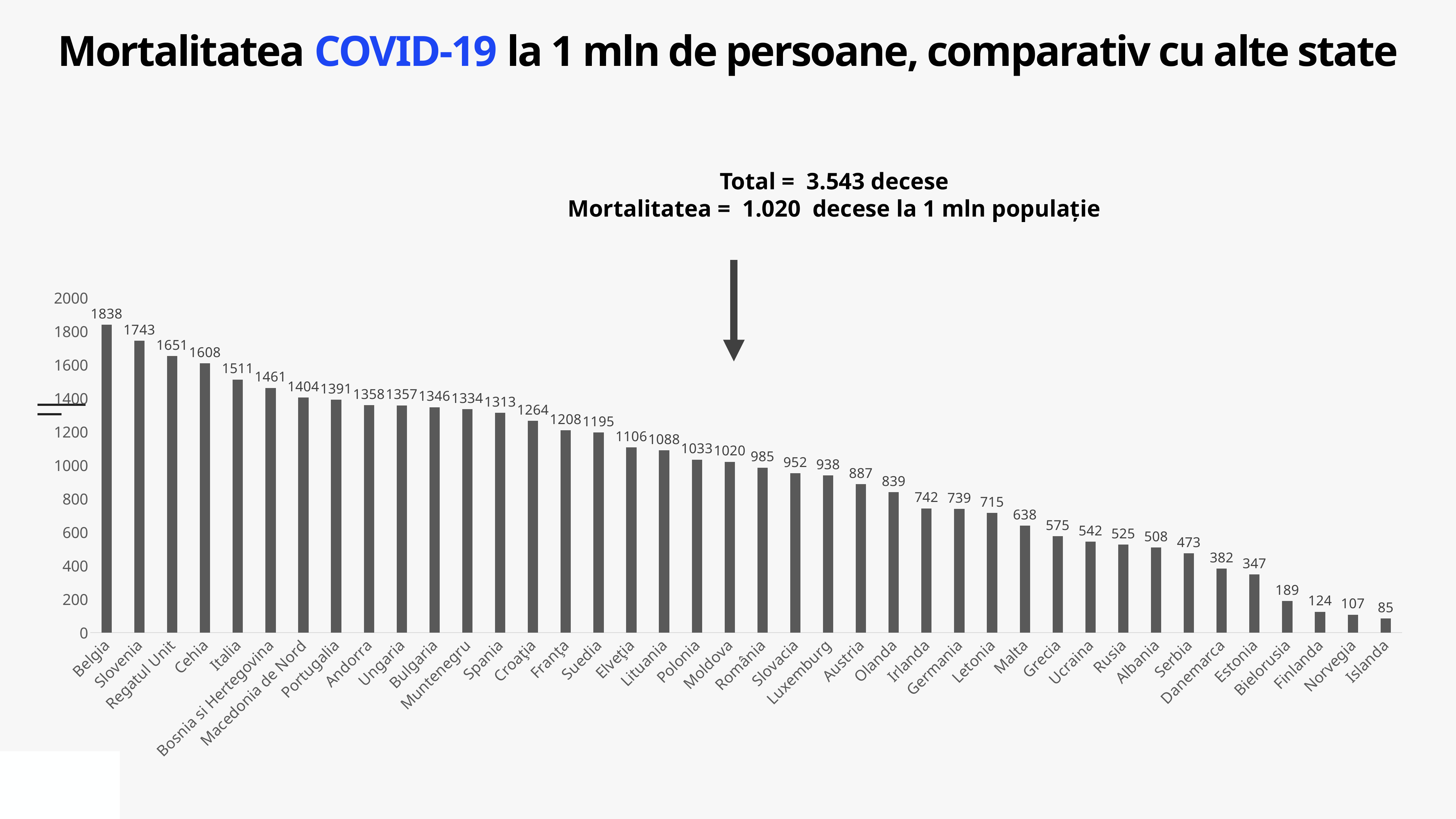
Do the values rise or fall from left to right along the x axis? Fall Which has a larger value, România or Austria? România Is the value for Malta greater or less than 600? greater What is the value for Belgia? 1838 What is the difference between the values for Belgia and Slovenia? 95 What is the value for Moldova? 1020 What kind of chart is shown on the slide? Bar chart Which country has the highest value? Belgia Which country has the lowest value? Islanda What is the value for Germania? 739 What is the value for Islanda? 85 How many countries are shown on the chart? 40